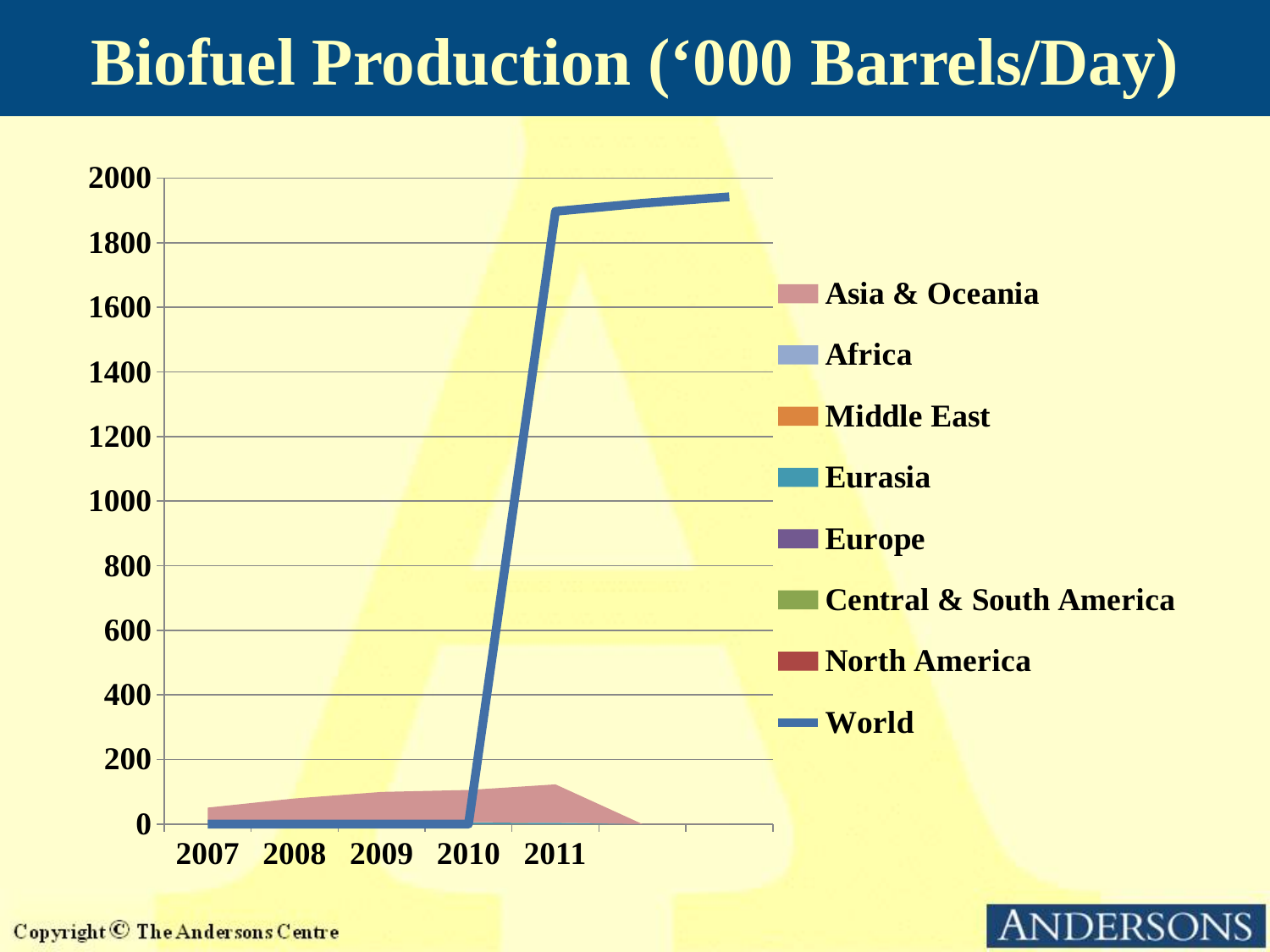
What colour is the World series in the legend? Blue Which is larger in 2011, the World value or the Asia & Oceania value? World How many year labels are shown on the x axis? 5 Does the World series rise or fall between 2010 and 2011? rise What is the title of the chart? Biofuel Production ('000 Barrels/Day) Is the value for World in 2007 greater or less than 200? less How many series does the legend list? 8 Is the value for World in 2010 greater or less than 200? less Is the value for Asia & Oceania in 2011 greater or less than 200? less What is the highest value shown on the y axis? 2000